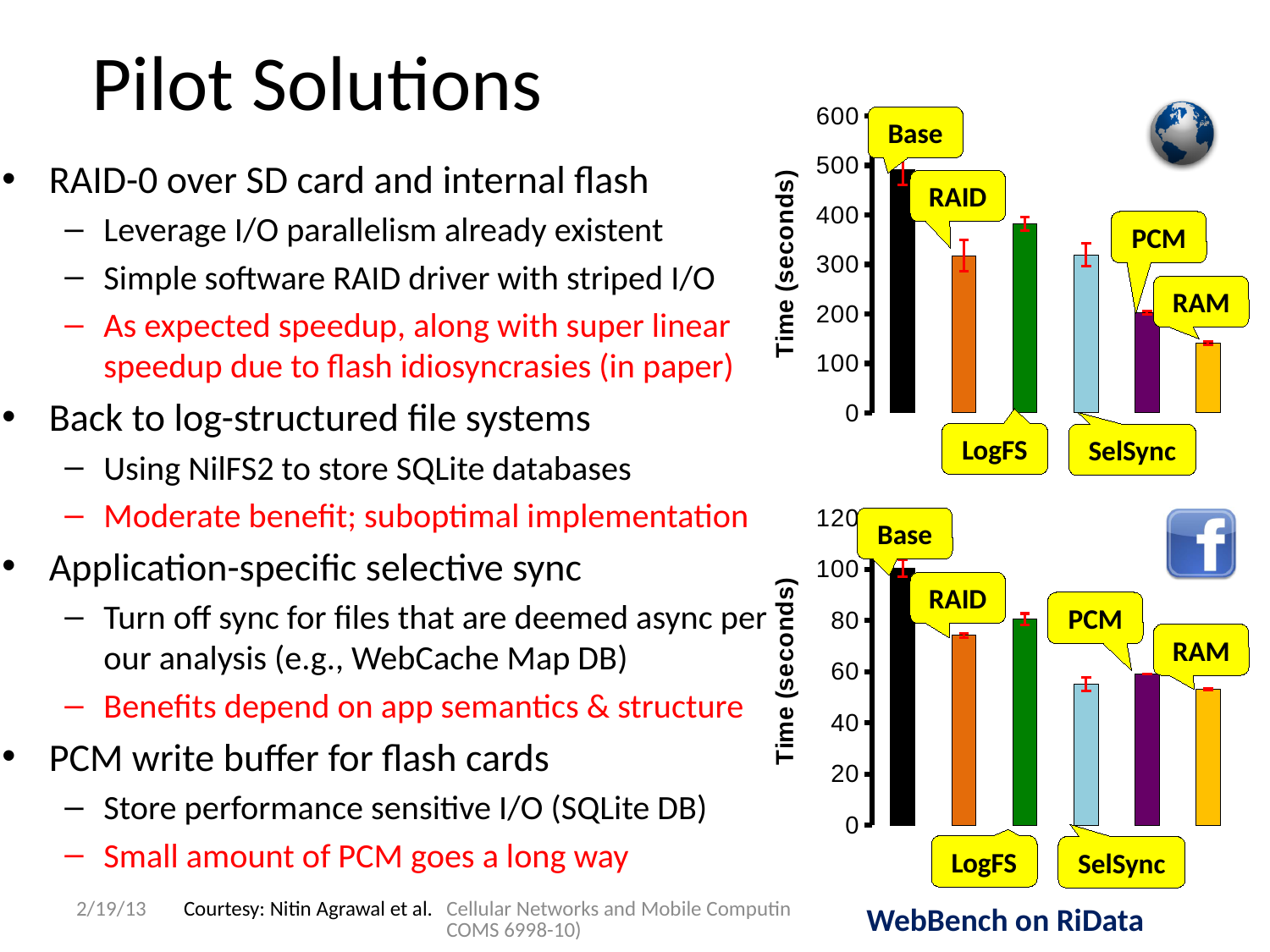
In the bottom chart, which category has the highest time? Base In the top chart, which category has the highest time? Base In the top chart, is the value for Base greater or less than 400? greater How many bars are plotted in the top chart? 6 In the top chart, which is larger, the value for LogFS or the value for PCM? LogFS What type of chart is the top chart on the slide? bar chart In the top chart, is the value for RAM greater or less than 200? less In the bottom chart, is the value for LogFS greater or less than 60? greater What is the y-axis label of the bottom chart? Time (seconds) In the bottom chart, which is larger, the value for RAID or the value for SelSync? RAID In the top chart, which category has the lowest time? RAM